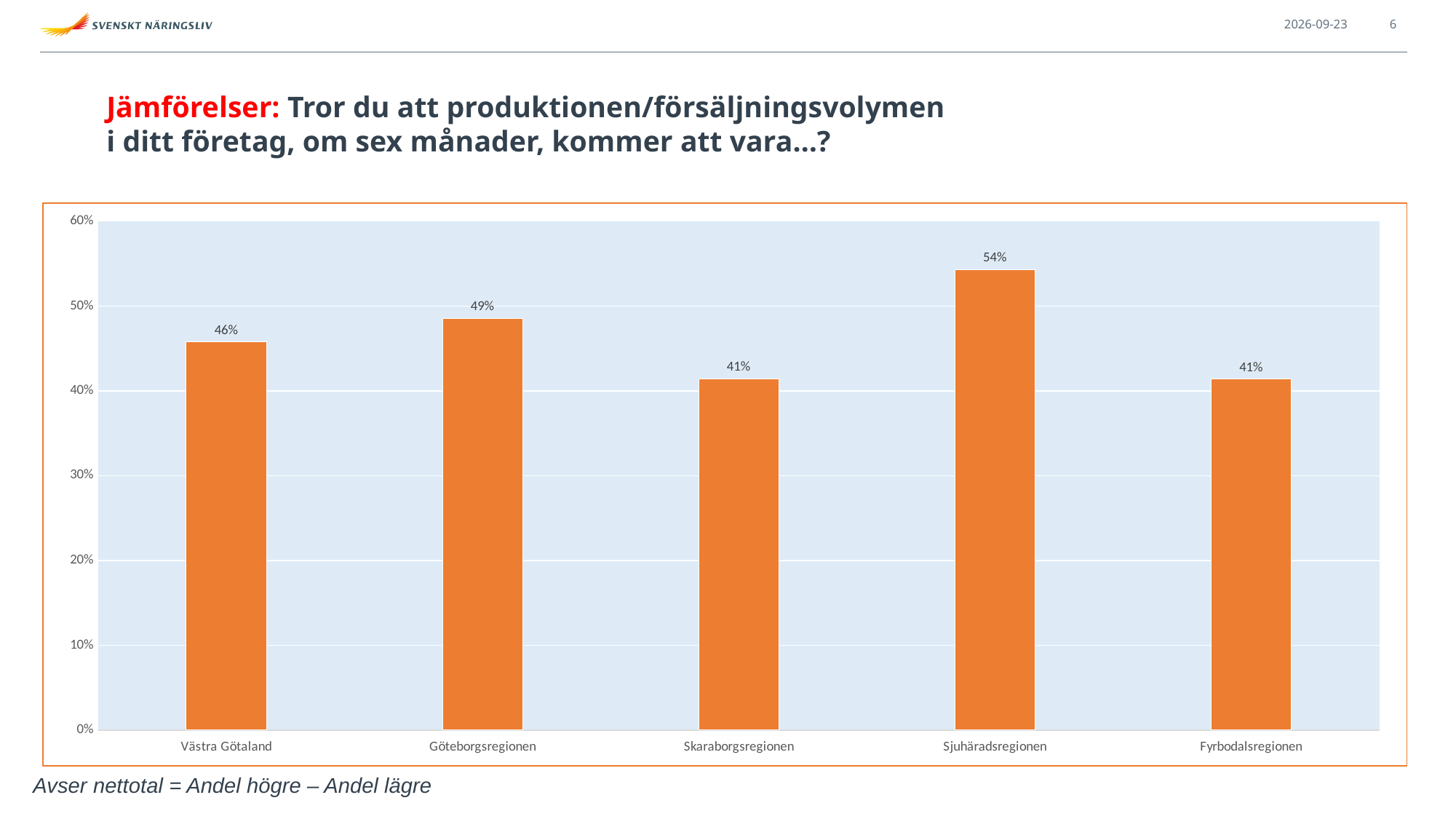
What is the value for Skaraborgsregionen? 41% Is the value for Sjuhäradsregionen greater or less than 50%? greater What colour are the bars in the chart? Orange Which is larger, the value for Göteborgsregionen or the value for Skaraborgsregionen? Göteborgsregionen Which region has the highest value? Sjuhäradsregionen How many regions are shown on the chart? 5 What is the difference between the values for Sjuhäradsregionen and Västra Götaland? 8% What is the value for Göteborgsregionen? 49% What kind of chart is shown on the slide? Bar chart What is the value for Sjuhäradsregionen? 54% What is the value for Västra Götaland? 46% What is the difference between the values for Göteborgsregionen and Fyrbodalsregionen? 8%